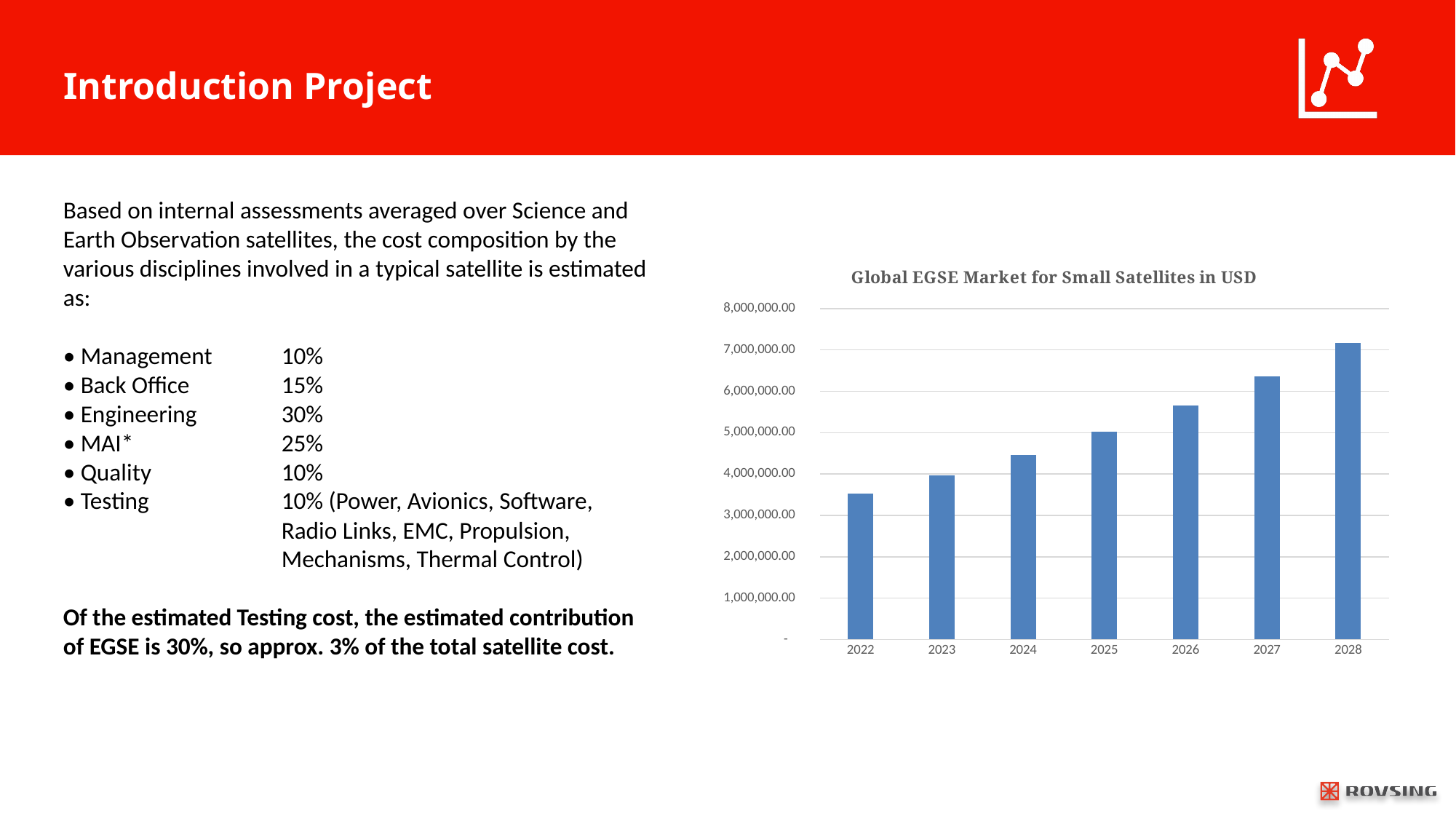
Which is larger, the value for 2027 or the value for 2024? 2027 Is the value for 2026 greater or less than 6,000,000.00? less Is the value for 2022 greater or less than 3,000,000.00? greater Is the value for 2022 greater or less than 4,000,000.00? less What is the title of the chart? Global EGSE Market for Small Satellites in USD Do the values in the chart rise or fall from 2022 to 2028? rise How many years are shown on the x axis of the chart? 7 Which year has the lowest value in the chart? 2022 What type of chart is shown on the slide? bar chart Which year has the highest value in the chart? 2028